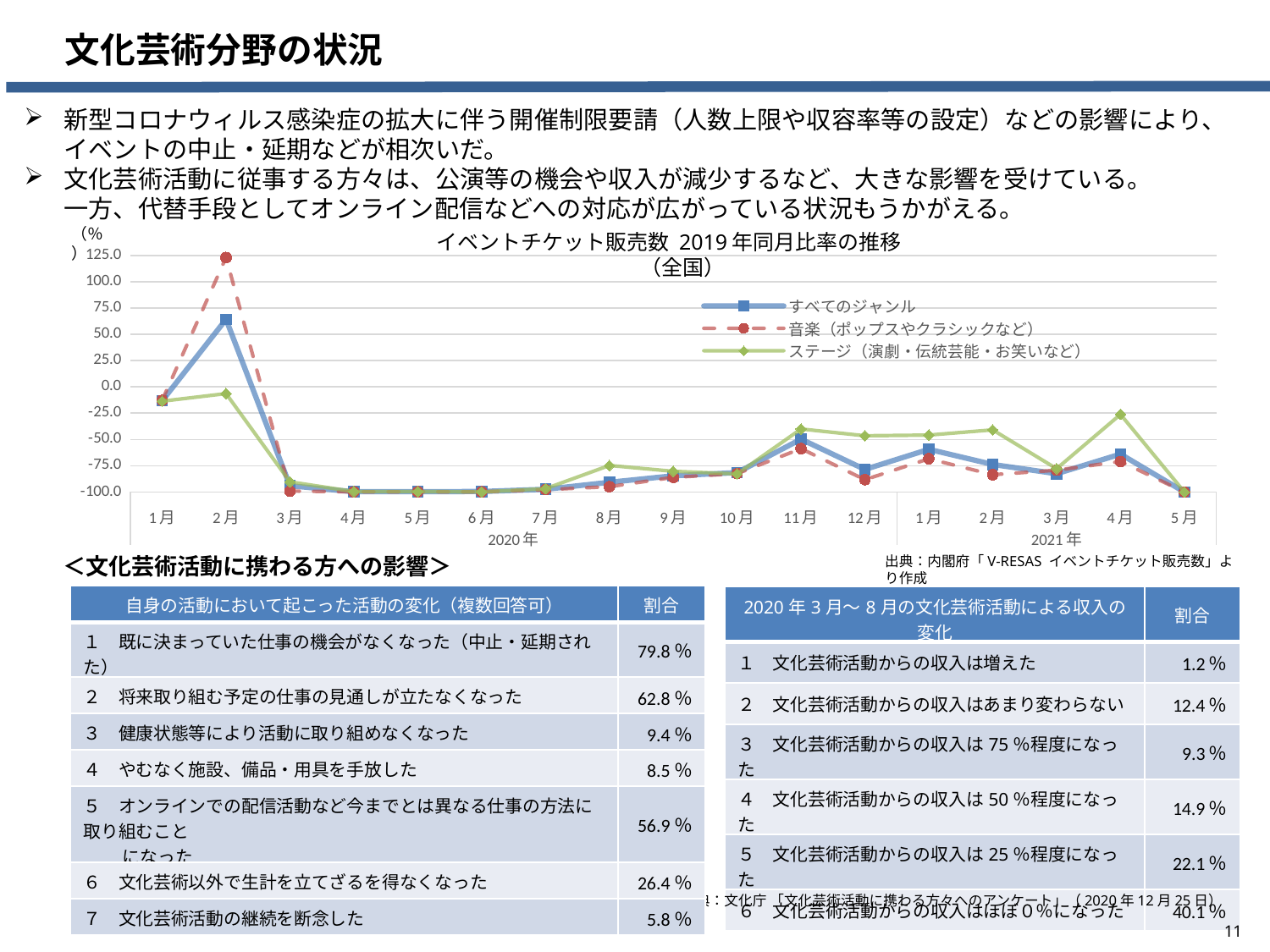
Is the value for ステージ（演劇・伝統芸能・お笑いなど） in 4月 2021 greater or less than -50.0? greater How many series does the legend of the line chart list? 3 In 2月 2020, which series has the larger value: 音楽（ポップスやクラシックなど） or ステージ（演劇・伝統芸能・お笑いなど）? 音楽（ポップスやクラシックなど） What kind of chart is shown on the slide? line chart Is the value for すべてのジャンル in 2月 2020 greater or less than 50.0? greater Is the value for ステージ（演劇・伝統芸能・お笑いなど） in 2月 2020 greater or less than 0.0? less In which month does the 音楽（ポップスやクラシックなど） series reach its highest value? 2月 2020 What is the title of the line chart? イベントチケット販売数 2019年同月比率の推移（全国） How many months are plotted along the x axis of the line chart? 17 Does the すべてのジャンル series rise or fall from 2月 2020 to 3月 2020? fall